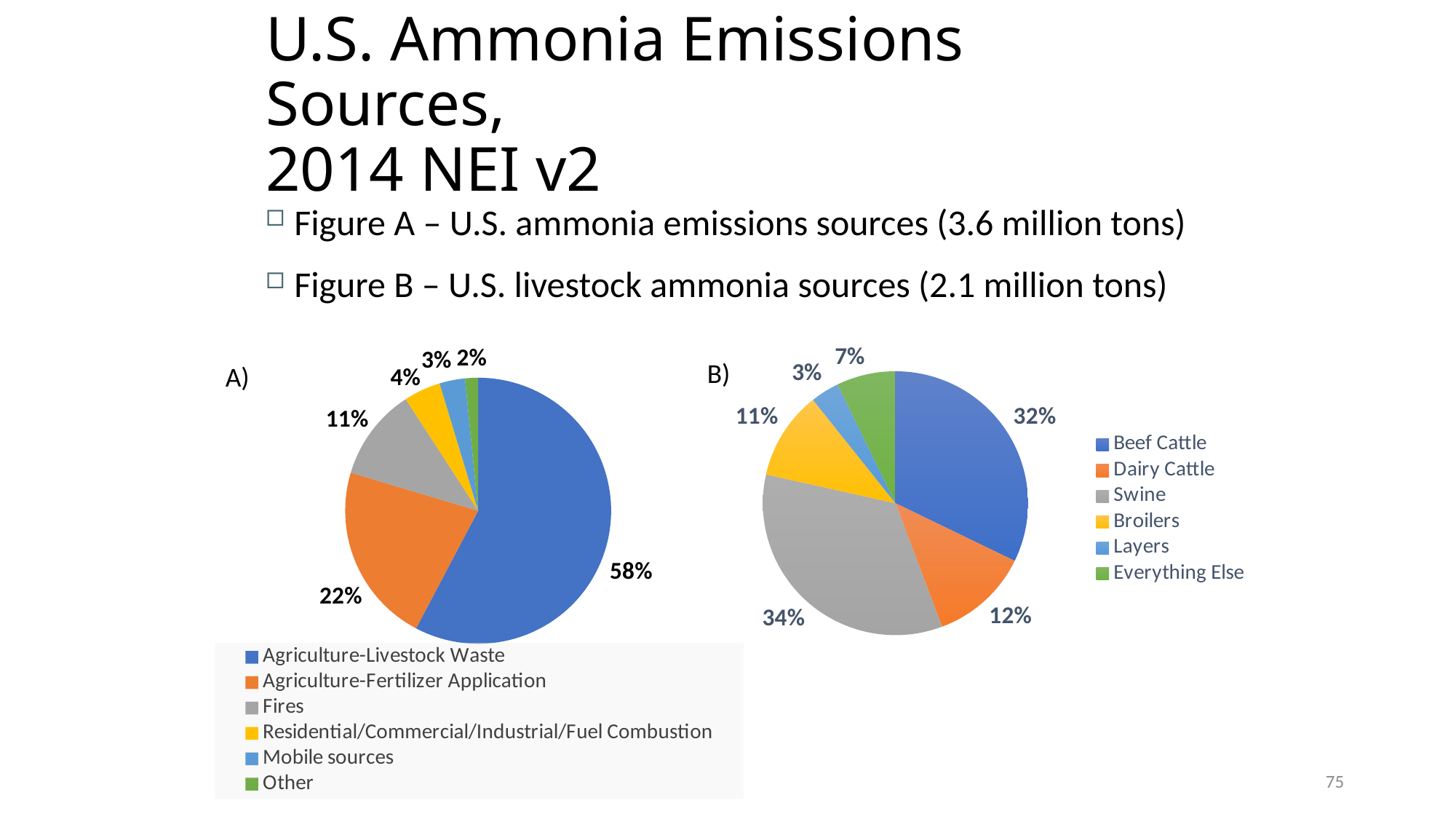
In Figure A (the left pie chart), what share of U.S. ammonia emissions comes from Agriculture-Livestock Waste? 58% In Figure B (the right pie chart), what is the difference in percentage points between Swine and Beef Cattle? 2 In Figure A (the left pie chart), what is the difference in percentage points between Agriculture-Livestock Waste and Agriculture-Fertilizer Application? 36 In Figure A (the left pie chart), what share is attributed to Fires? 11% In Figure B (the right pie chart), which is larger, Beef Cattle or Broilers? Beef Cattle In Figure B (the right pie chart), what share is Dairy Cattle? 12% What type of chart is used for Figure A and Figure B? Pie chart In Figure B (the right pie chart), which category has the smallest share? Layers In Figure A (the left pie chart), how many categories does the legend list? 6 In Figure B (the right pie chart), what share of livestock ammonia sources is Swine? 34% In Figure A (the left pie chart), which source has the smallest share? Other In Figure A (the left pie chart), which source has the largest share? Agriculture-Livestock Waste